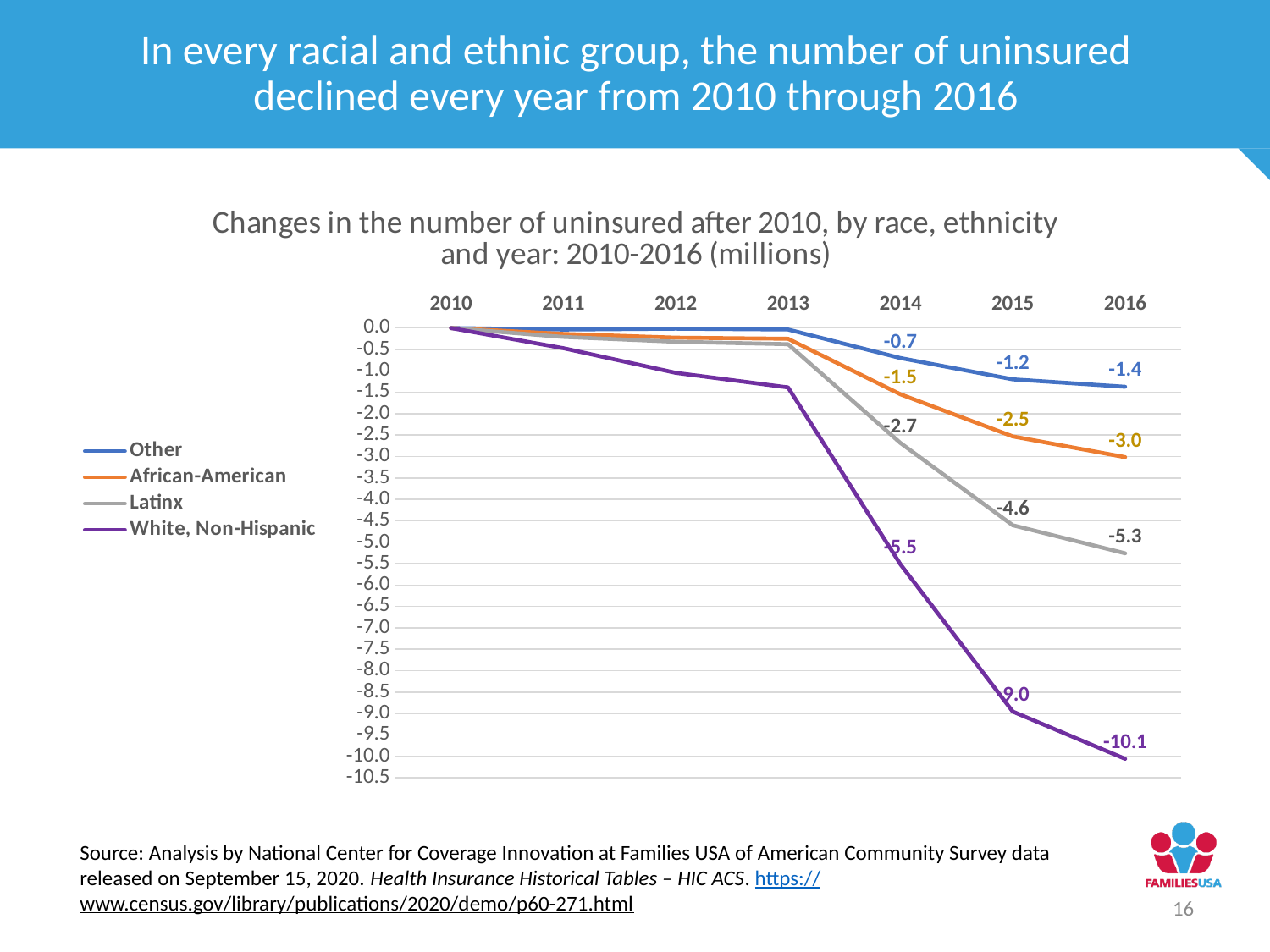
What is the difference between the White, Non-Hispanic values in 2015 and 2016? 1.1 How many series does the legend list? 4 What kind of chart is shown on the slide? Line chart What is the value for African-American in 2014? -1.5 Which is larger in 2014, the value for Latinx or the value for African-American? African-American Is the value for White, Non-Hispanic in 2013 greater or less than -2.0? greater Which series has the highest value in 2015? Other Which series has the lowest value in 2016? White, Non-Hispanic Do the values for Latinx rise or fall from 2010 to 2016? Fall What is the value for Other in 2016? -1.4 What is the value for Latinx in 2015? -4.6 What is the value for White, Non-Hispanic in 2016? -10.1